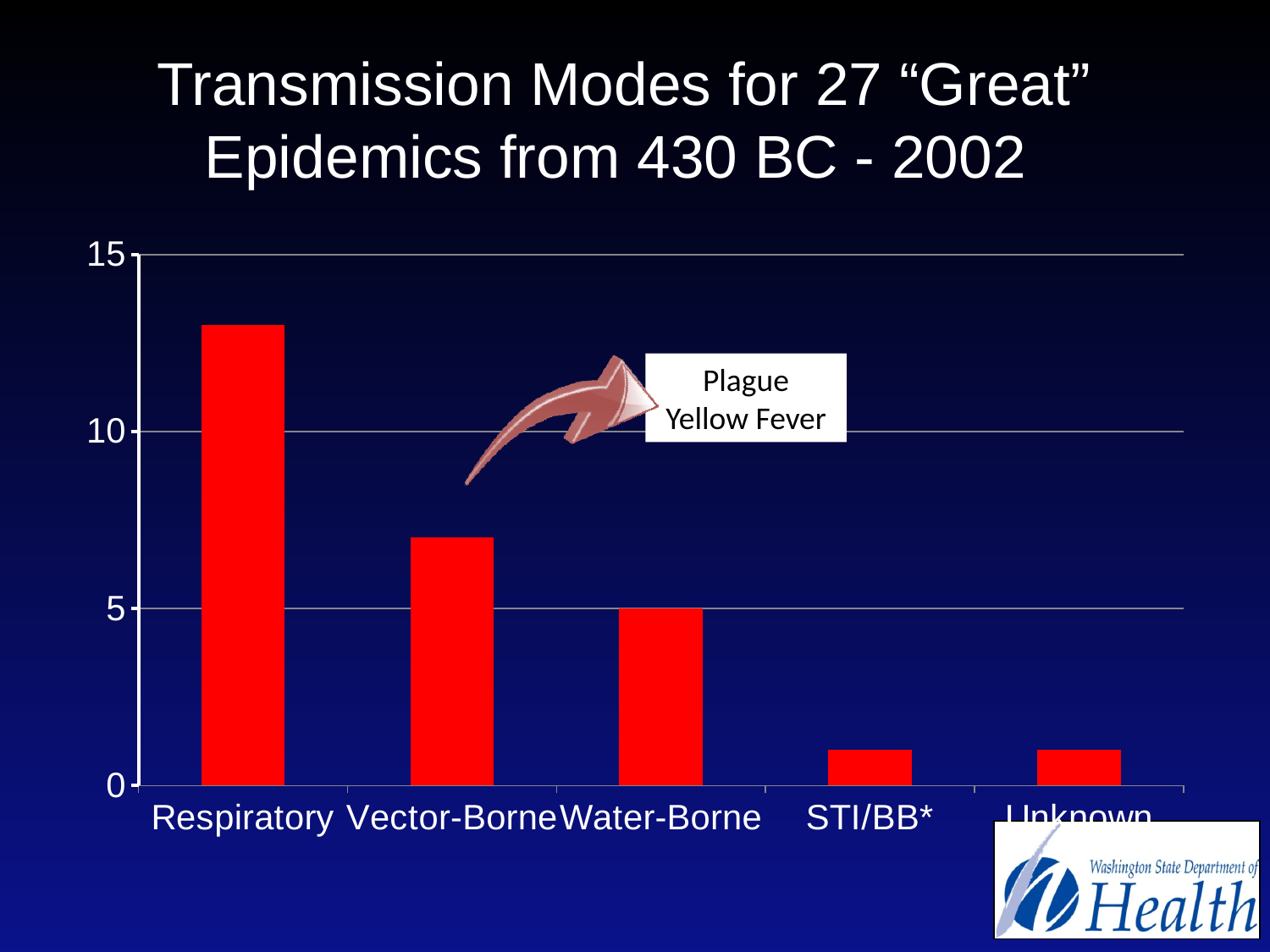
Which two diseases does the callout box on the chart name? Plague and Yellow Fever Is the value for Vector-Borne greater or less than 10? less What is the title of the chart? Transmission Modes for 27 "Great" Epidemics from 430 BC - 2002 Do the bar values generally rise or fall moving from left to right along the x axis? Fall Is the value for STI/BB* greater or less than 5? less Is the value for Vector-Borne greater or less than 5? greater What is the value for Water-Borne? 5 What type of chart is shown on the slide? Bar chart How many transmission mode categories are shown on the x axis? 5 Which is larger, the value for Vector-Borne or the value for Water-Borne? Vector-Borne Which transmission mode has the highest number of epidemics? Respiratory